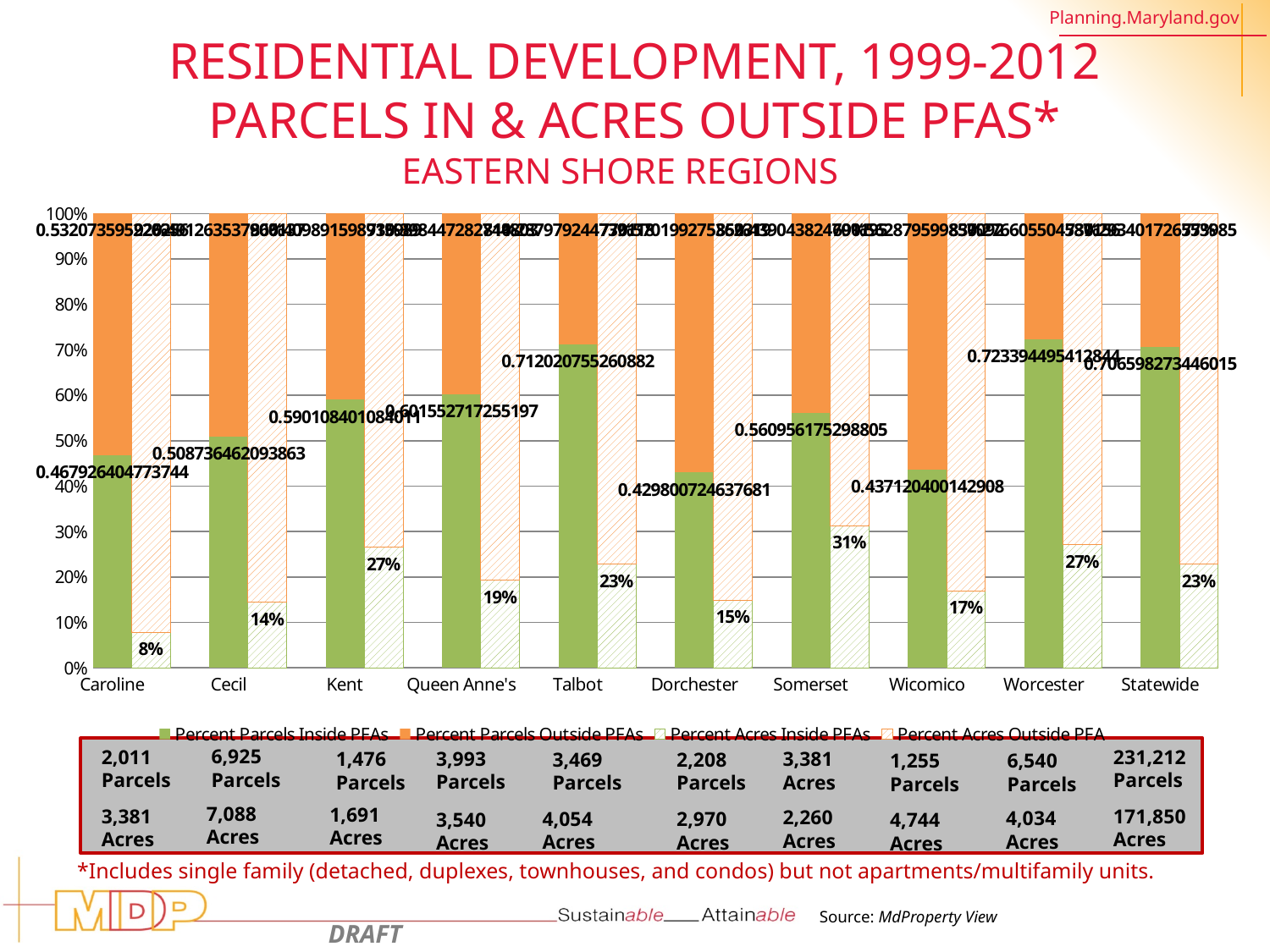
What is the Percent Acres Inside PFAs value for Caroline? 8% What is the difference between the Percent Acres Inside PFAs values for Kent and Cecil? 13 percentage points How many series does the chart legend list? 4 Which region has the highest Percent Acres Inside PFAs value? Somerset What kind of chart is shown on the slide? bar chart What is the Percent Acres Inside PFAs value for Statewide? 23% Which has a larger Percent Acres Inside PFAs value, Kent or Queen Anne's? Kent How many regions are shown along the x axis of the chart? 10 Is the Percent Parcels Inside PFAs value for Dorchester greater or less than 50%? less What is the Percent Acres Inside PFAs value for Somerset? 31% Is the Percent Parcels Inside PFAs value for Talbot greater or less than 60%? greater Which region has the lowest Percent Acres Inside PFAs value? Caroline